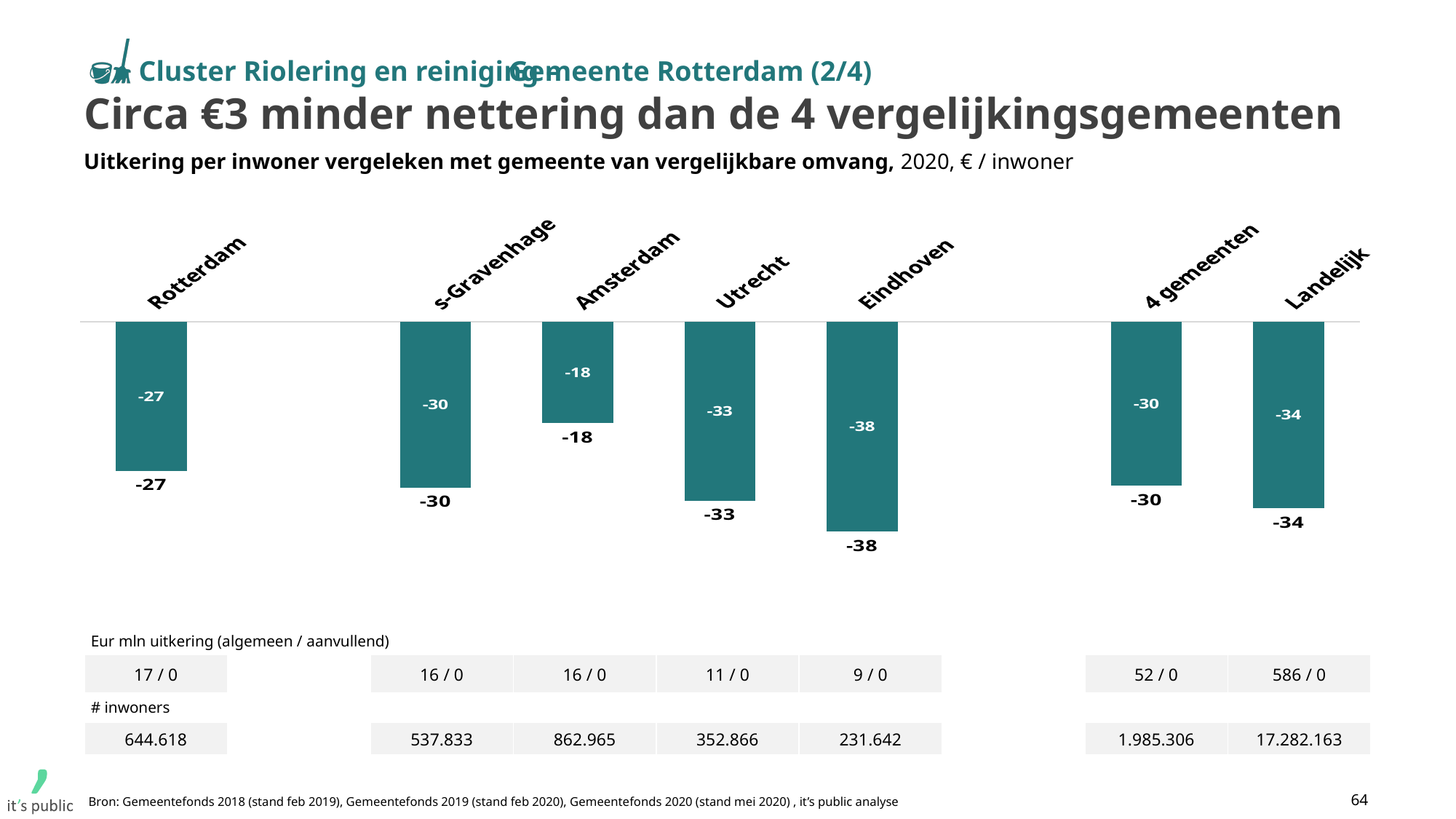
What is the value for Landelijk? -34 How many bars are plotted in the chart? 7 Which category has the highest (least negative) value? Amsterdam What kind of chart is shown on the slide? Bar chart What is the value for Eindhoven? -38 What is the difference between the values for Rotterdam and 4 gemeenten? 3 What is the difference between the values for Utrecht and Amsterdam? 15 What is the value for Amsterdam? -18 Which category has the lowest (most negative) value? Eindhoven What is the unit stated in the chart subtitle? € / inwoner What is the value for Rotterdam? -27 Which is larger, the value for Rotterdam or the value for Landelijk? Rotterdam